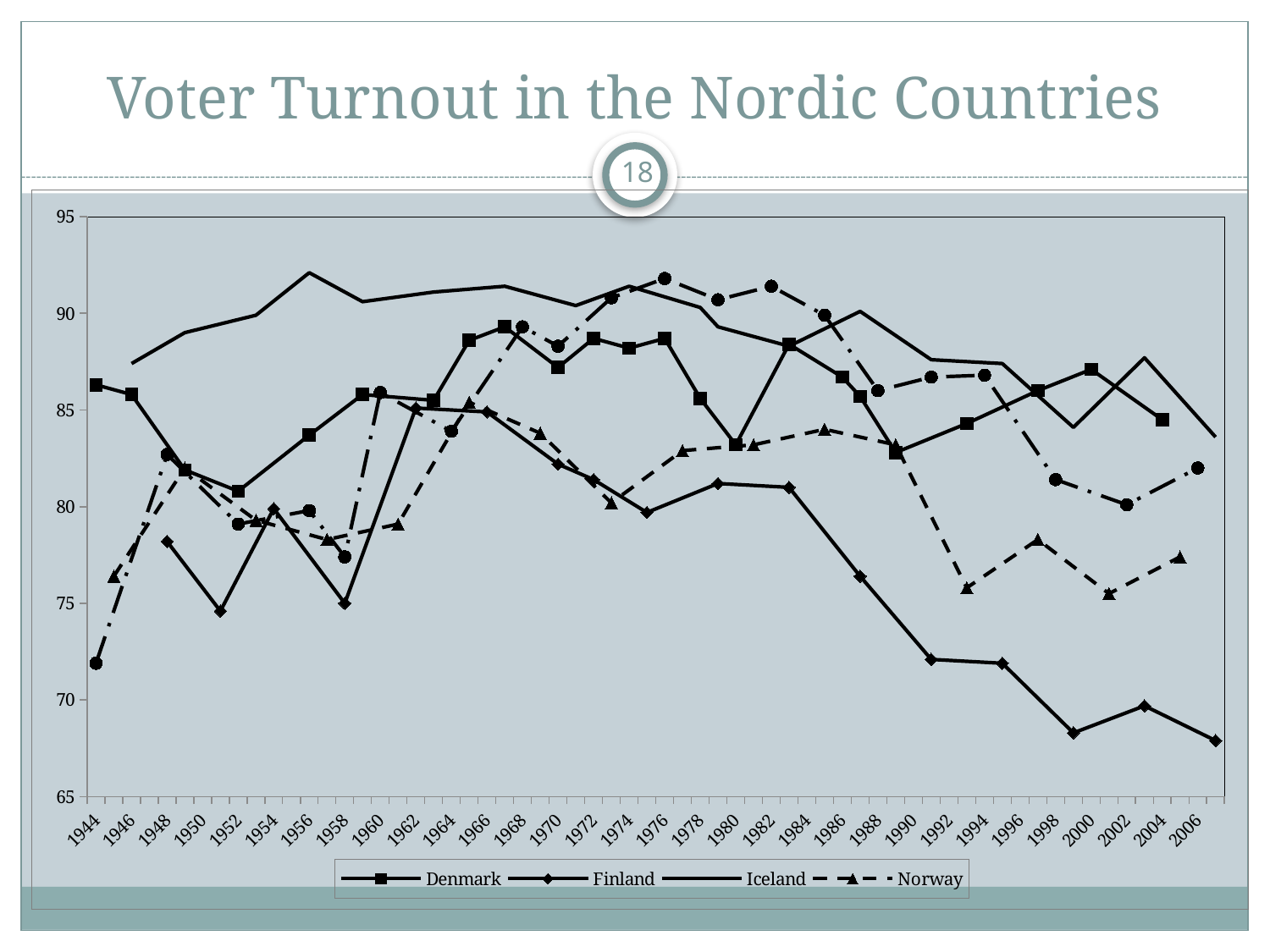
Does the Finland line rise or fall from 1984 to 2006? fall In 2006, which is larger, the value for Iceland or the value for Finland? Iceland Is the value for Finland in 2006 greater or less than 70? less Is the value for Iceland in 1956 greater or less than 90? greater Is the value for Denmark in 1944 greater or less than 85? greater How many series does the legend list? 4 Which series has the lowest value in 2006? Finland What is the title of the chart on the slide? Voter Turnout in the Nordic Countries Which series is shown with a dashed line and triangle markers in the legend? Norway What kind of chart is shown on the slide? line chart